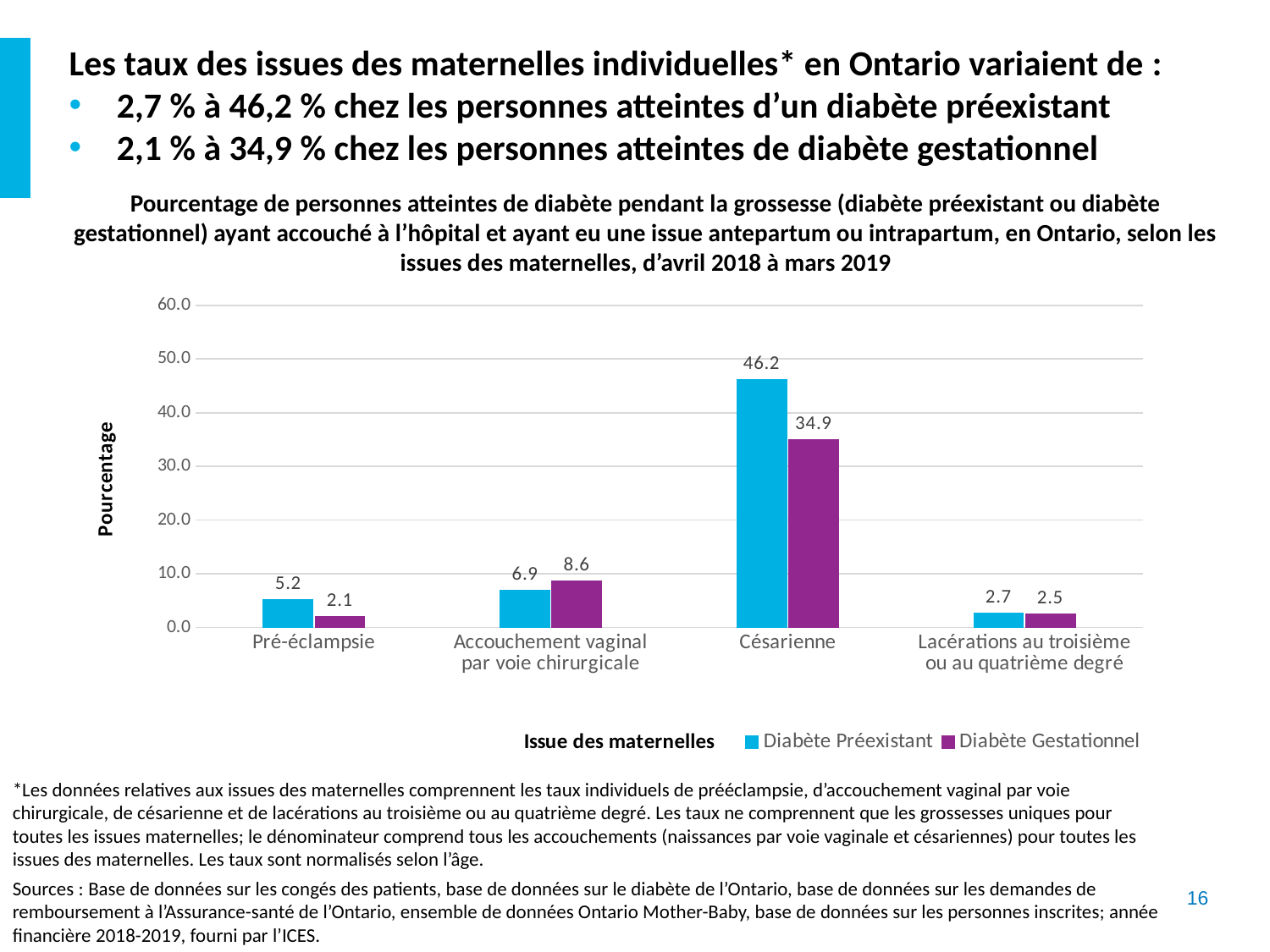
What kind of chart is shown on the slide? bar chart What is the difference between the Diabète Préexistant and Diabète Gestationnel values for Césarienne? 11.3 Which is larger for Accouchement vaginal par voie chirurgicale: Diabète Préexistant or Diabète Gestationnel? Diabète Gestationnel What is the value for Diabète Gestationnel in the Pré-éclampsie category? 2.1 What is the value for Diabète Gestationnel in the Accouchement vaginal par voie chirurgicale category? 8.6 How many series does the legend list? 2 Which category has the highest value for Diabète Préexistant? Césarienne Which category has the lowest value for Diabète Gestationnel? Pré-éclampsie Is the value for Diabète Gestationnel in the Césarienne category greater or less than 30.0? greater What is the label of the y axis? Pourcentage How many categories are shown on the x axis? 4 What is the value for Diabète Préexistant in the Césarienne category? 46.2